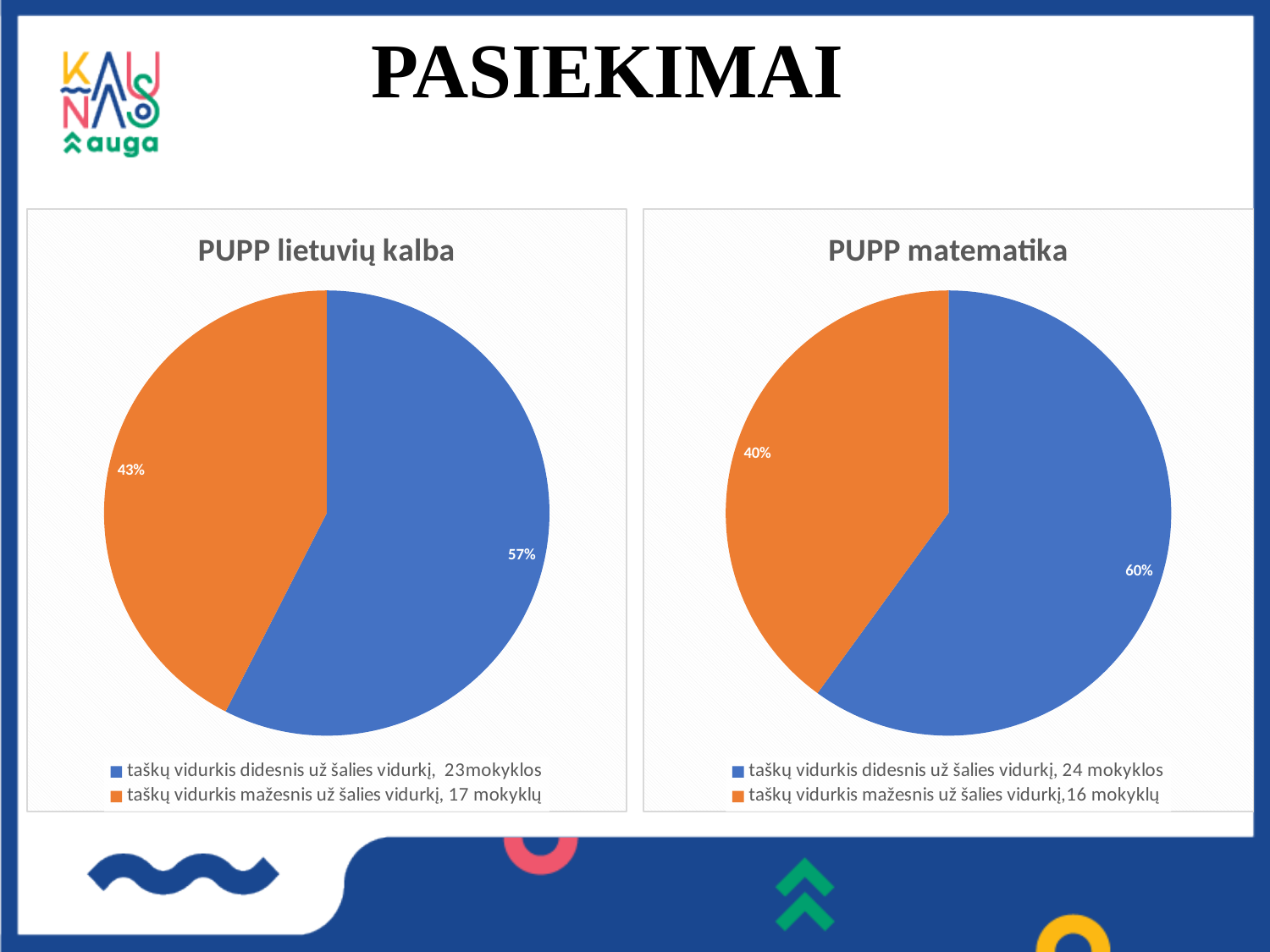
What kind of chart is the 'PUPP lietuvių kalba' chart? pie chart In the 'PUPP lietuvių kalba' chart, which slice is the largest? taškų vidurkis didesnis už šalies vidurkį, 23 mokyklos In the 'PUPP lietuvių kalba' chart, what share of the pie is the slice for schools whose average is lower than the national average (taškų vidurkis mažesnis už šalies vidurkį)? 43% In the 'PUPP lietuvių kalba' chart, what is the difference in percentage points between the two slices? 14 In the 'PUPP matematika' chart, what is the difference in percentage points between the two slices? 20 Which is larger: the share of schools above the national average in 'PUPP lietuvių kalba' or in 'PUPP matematika'? PUPP matematika In the 'PUPP lietuvių kalba' chart, what share of the pie is the slice for schools whose average is higher than the national average (taškų vidurkis didesnis už šalies vidurkį)? 57% How many slices does the 'PUPP matematika' pie chart have? 2 In the 'PUPP lietuvių kalba' chart, what colour is the slice for schools whose average is lower than the national average? orange In the 'PUPP matematika' chart, what share of the pie is the slice for schools whose average is higher than the national average? 60% In the 'PUPP matematika' chart, which slice is the smallest? taškų vidurkis mažesnis už šalies vidurkį, 16 mokyklų